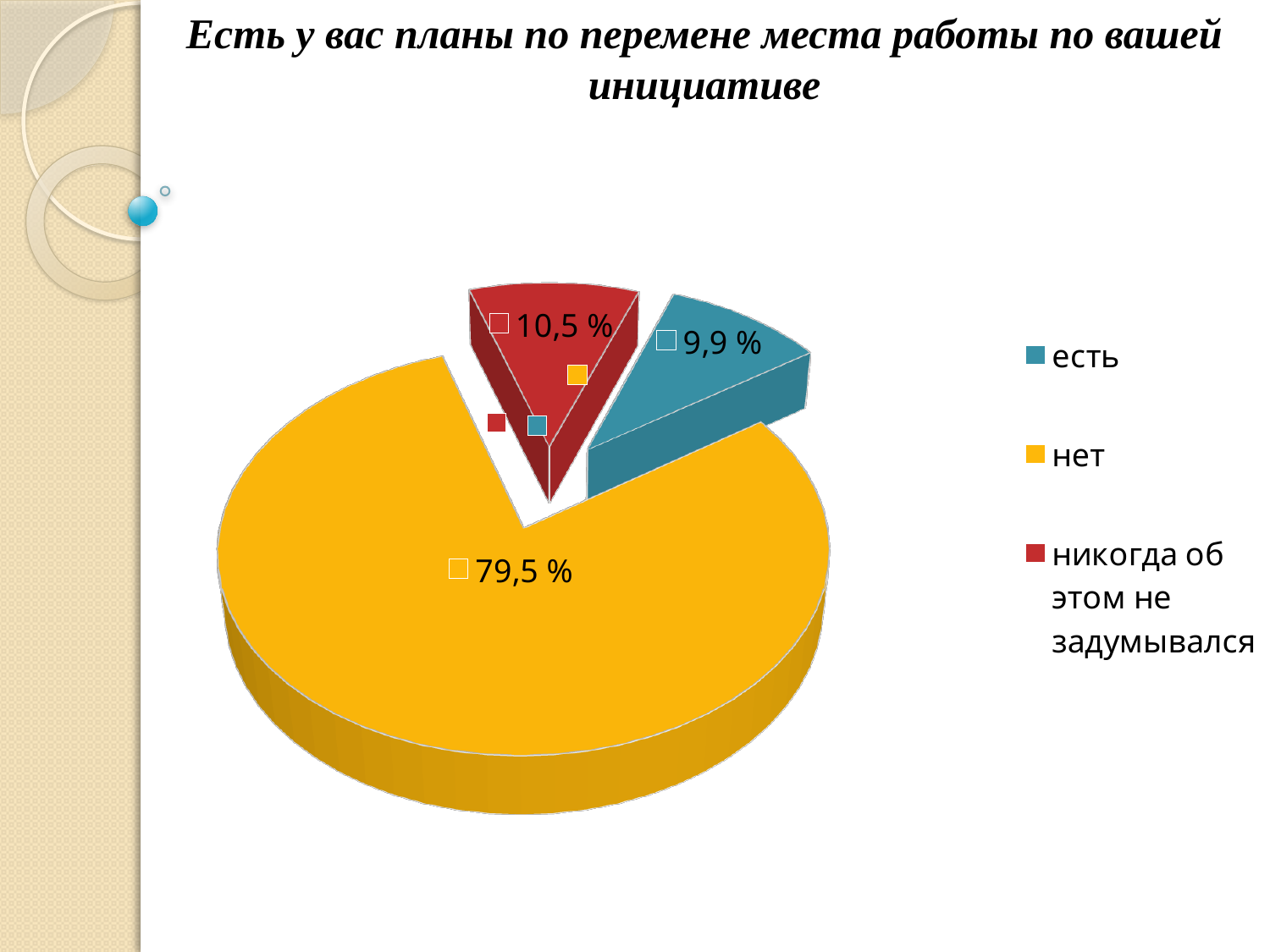
Which is larger: the "есть" slice or the "никогда об этом не задумывался" slice? никогда об этом не задумывался What kind of chart is shown on the slide? pie chart Which category has the largest slice of the pie? нет What is the difference between the "нет" slice and the "есть" slice? 69,6 % What percentage is shown for the "никогда об этом не задумывался" slice? 10,5 % What percentage is shown for the "нет" slice? 79,5 % What colour is the "нет" slice in the pie chart? yellow What is the title of the chart on the slide? Есть у вас планы по перемене места работы по вашей инициативе What percentage is shown for the "есть" slice? 9,9 % Which category has the smallest slice of the pie? есть How many slices does the pie chart have? 3 What is the difference between the "никогда об этом не задумывался" slice and the "есть" slice? 0,6 %